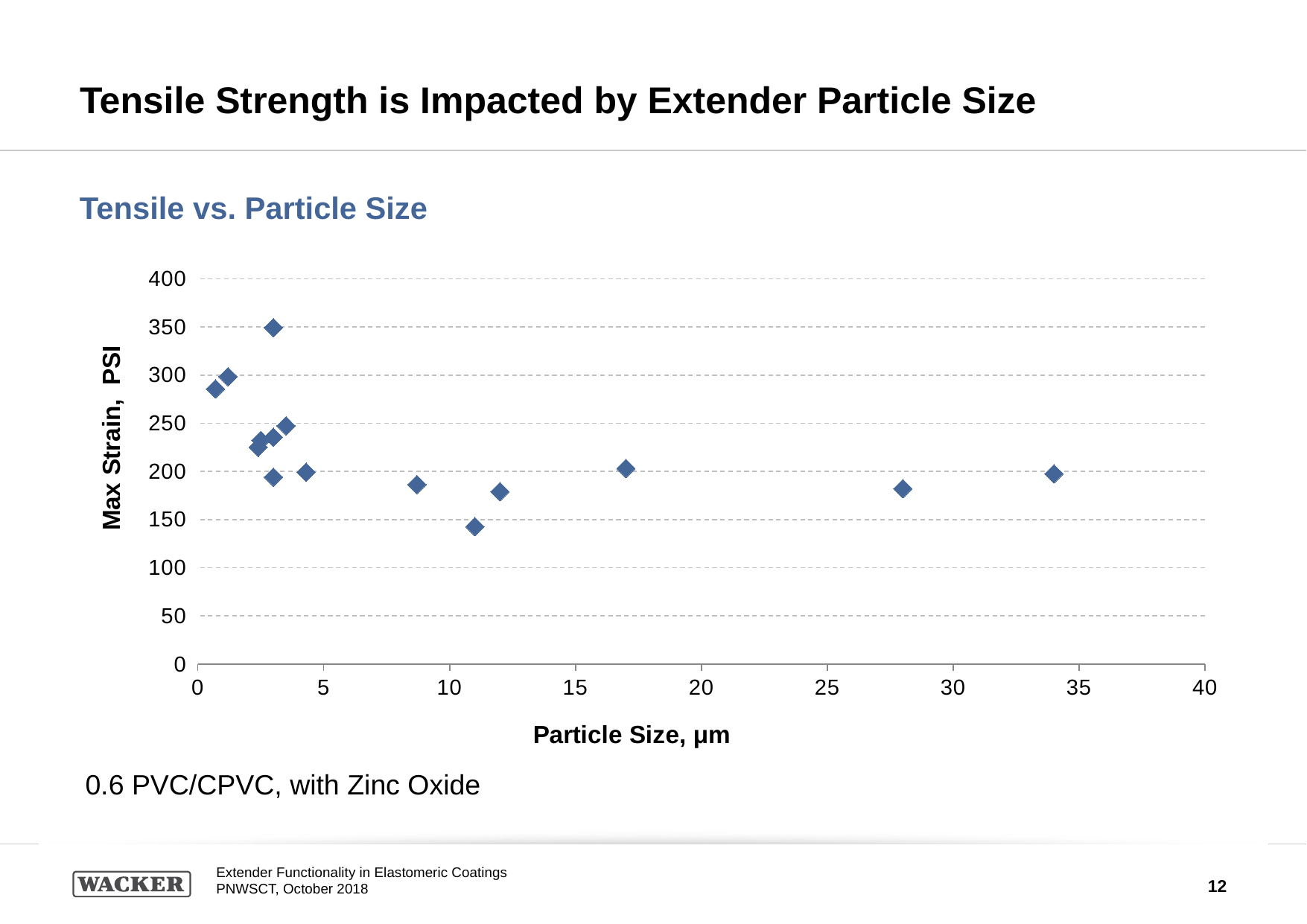
Is the highest point on the chart greater or less than 300 PSI? greater Which has the higher Max Strain: the point at about 1 µm or the point at about 34 µm? the point at about 1 µm Overall, does Max Strain rise or fall as particle size increases along the x axis? fall Is the value for the point at about 34 µm particle size greater or less than 250 PSI? less Which has the higher Max Strain: the point at about 11 µm or the point at about 17 µm? the point at about 17 µm What kind of chart is shown on the slide? scatter chart Is the value for the point at about 17 µm particle size greater or less than 150 PSI? greater What is the maximum value shown on the vertical axis? 400 What is the label of the vertical axis? Max Strain, PSI What is the title of the chart? Tensile vs. Particle Size